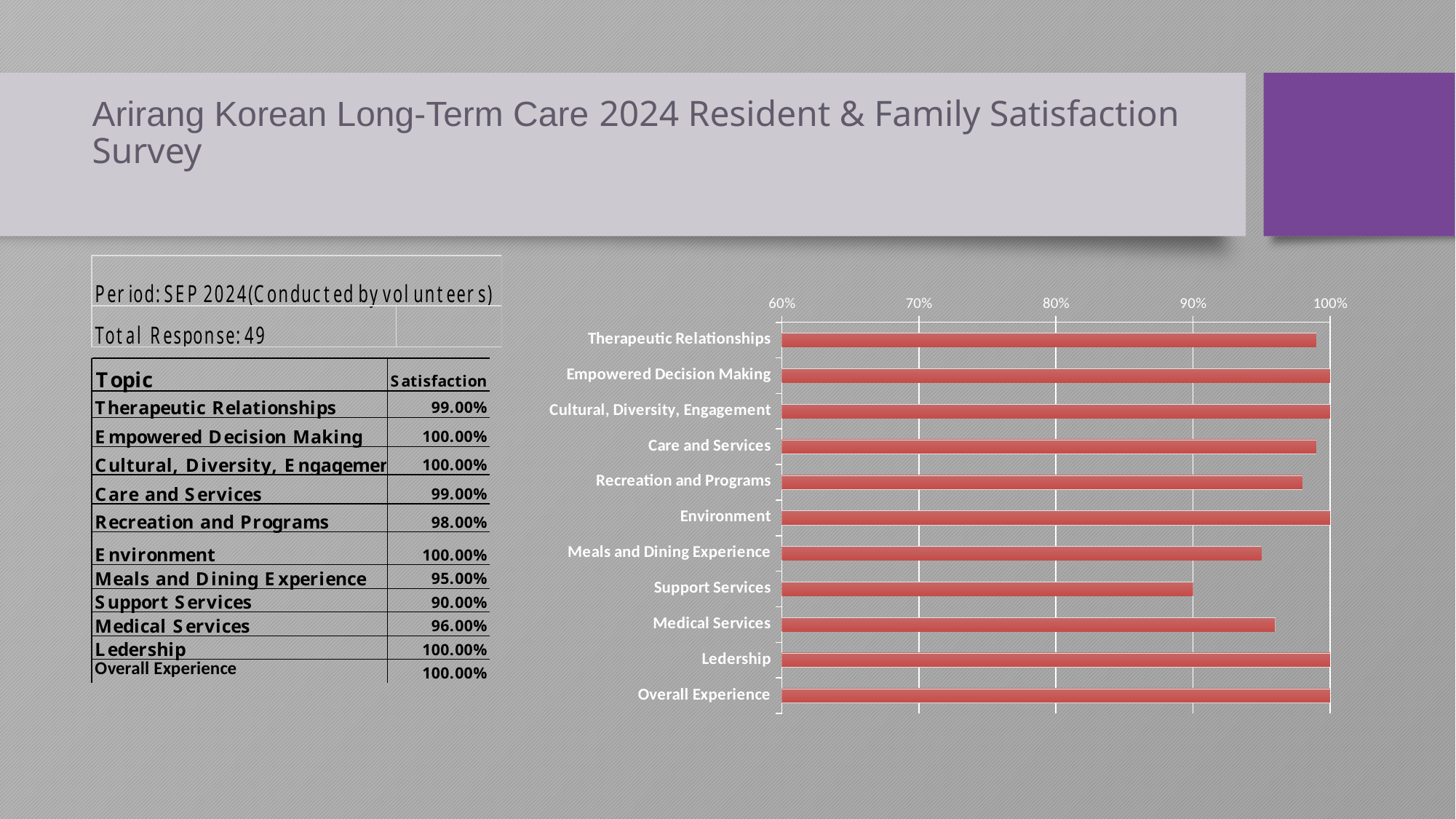
Is the value for Medical Services greater or less than 100%? less Which topic has the lowest satisfaction in the bar chart? Support Services How many topics are plotted in the bar chart? 11 Which is larger, the satisfaction for Meals and Dining Experience or for Support Services? Meals and Dining Experience What is the satisfaction value for Recreation and Programs? 98.00% Is the value for Meals and Dining Experience greater or less than 90%? greater What kind of chart is shown on the slide? bar chart What colour are the bars in the chart? red What is the satisfaction value for Meals and Dining Experience? 95.00% What is the difference between the satisfaction for Medical Services and for Support Services? 6.00% What is the satisfaction value for Support Services? 90.00% What is the lowest value shown on the chart's horizontal axis? 60%